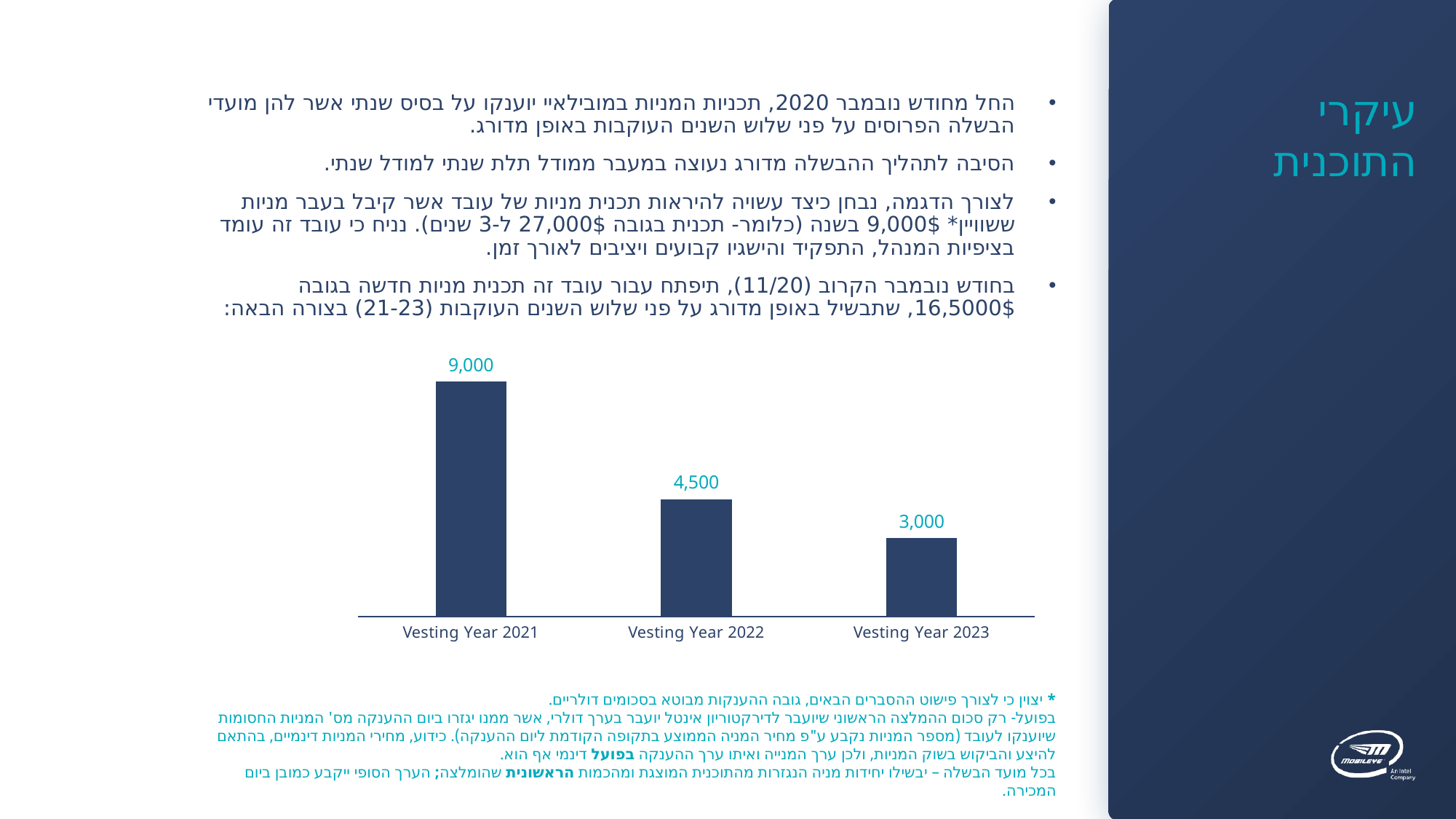
What is the difference between the values for Vesting Year 2022 and Vesting Year 2023? 1,500 What is the value for Vesting Year 2021? 9,000 What is the value for Vesting Year 2022? 4,500 Which vesting year has the lowest value? Vesting Year 2023 Which is larger, the value for Vesting Year 2022 or Vesting Year 2023? Vesting Year 2022 What is the total of the three vesting year values shown in the chart? 16,500 What is the difference between the values for Vesting Year 2021 and Vesting Year 2022? 4,500 What is the value for Vesting Year 2023? 3,000 Which vesting year has the highest value? Vesting Year 2021 Do the values rise or fall from Vesting Year 2021 to Vesting Year 2023? Fall How many categories are shown on the x axis of the chart? 3 What kind of chart is shown on the slide? Bar chart